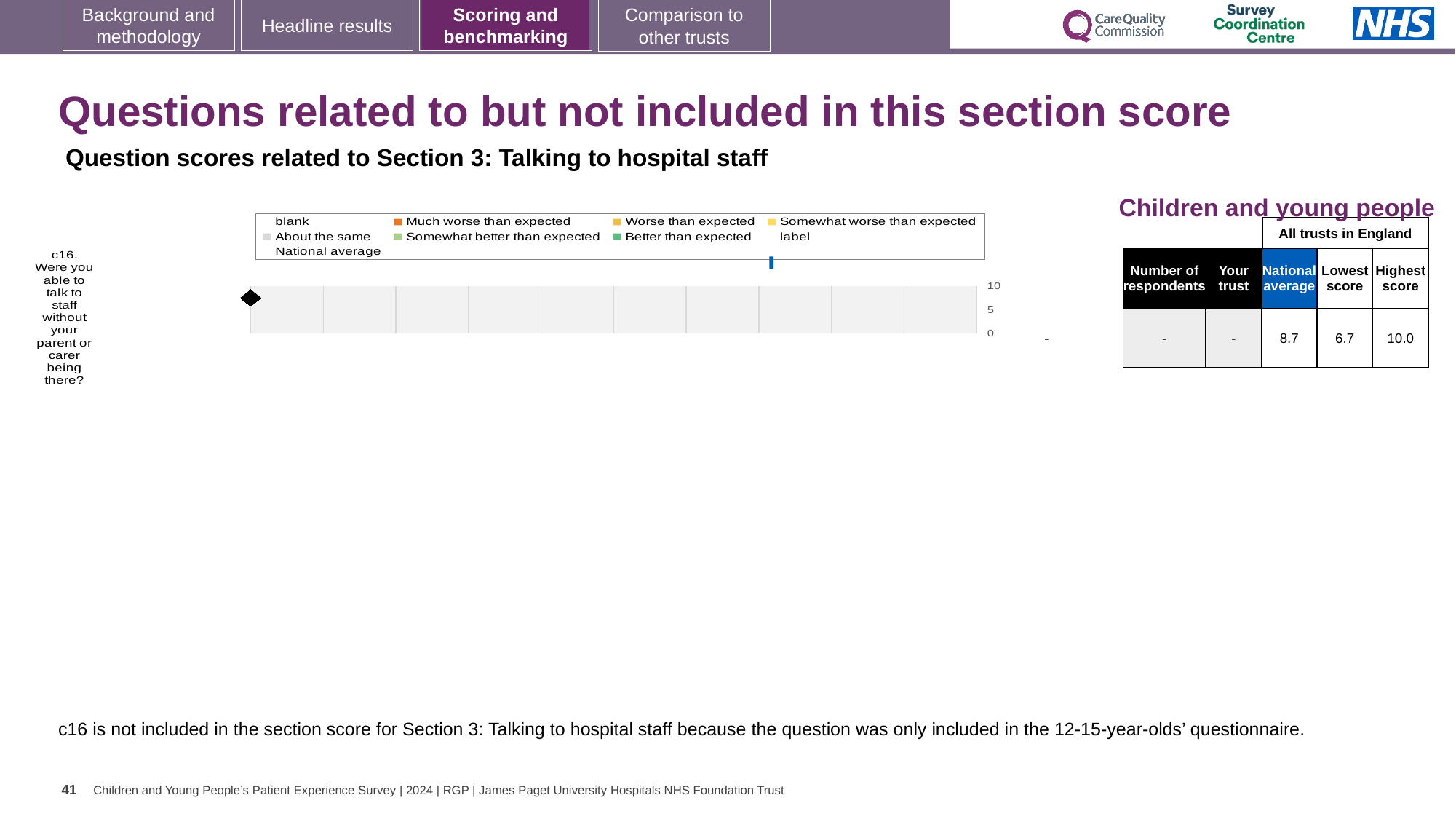
In the Children and young people table, what is shown in the 'Your trust' column for c16? - In the Children and young people table, what is the difference between the Highest score and the Lowest score for c16? 3.3 In the Children and young people table, which is larger for c16: the National average or the Lowest score? National average In the Children and young people table, what is the National average score for c16? 8.7 What kind of chart is shown on the slide? bar chart How many entries does the chart legend list? 9 How many survey questions are plotted as categories on the chart? 1 What is the highest tick value shown on the chart's value axis? 10 In the Children and young people table, what is the Highest score for c16? 10.0 What colour does the legend use for 'Much worse than expected'? orange Which question number is plotted on the chart? c16 In the Children and young people table, what is the Lowest score for c16? 6.7